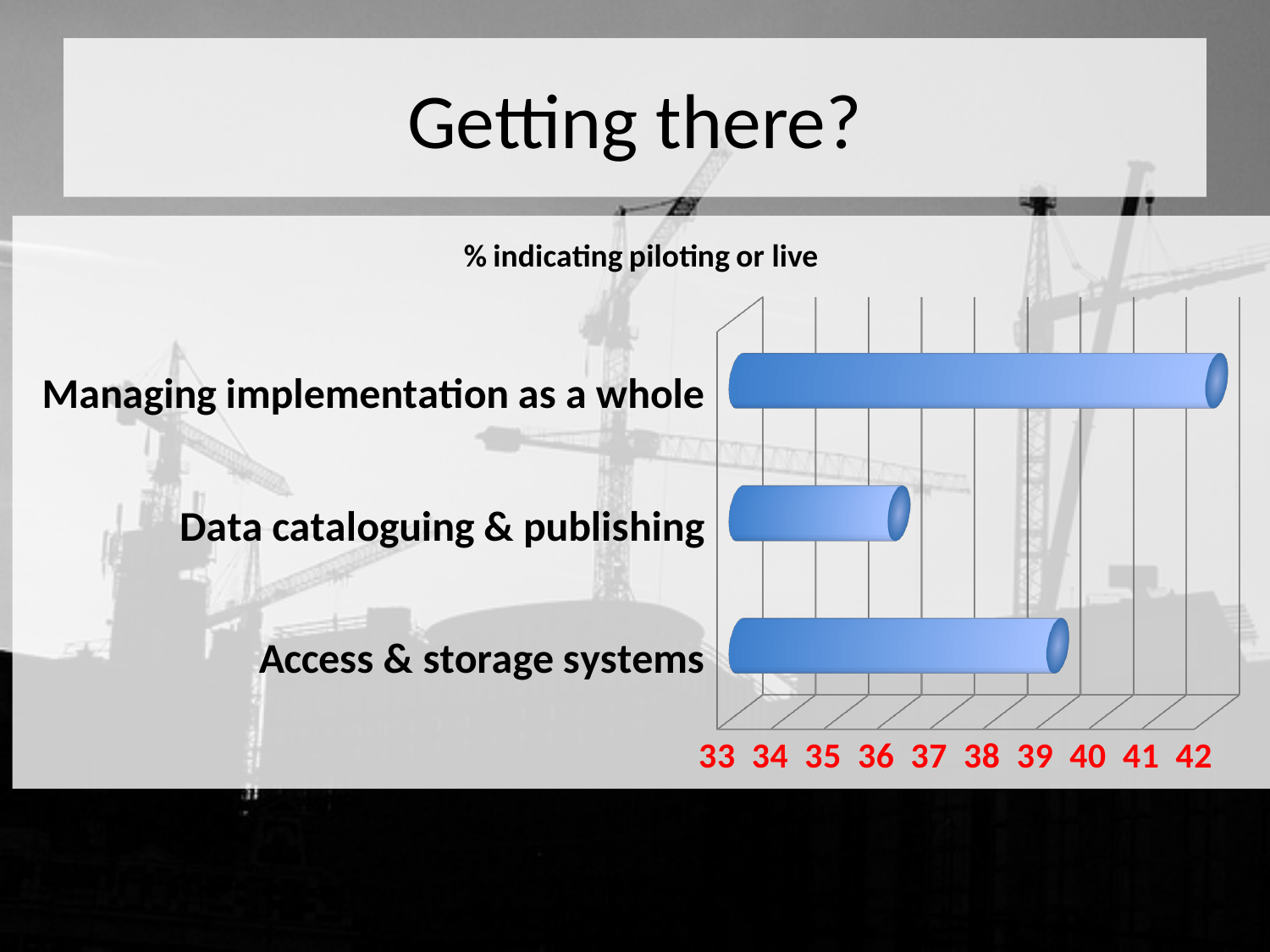
What kind of chart is shown on the slide? bar chart Which category has the lowest value? Data cataloguing & publishing Which category has the highest value? Managing implementation as a whole Is the value for Data cataloguing & publishing greater or less than 38? less Which is larger, the value for Managing implementation as a whole or the value for Access & storage systems? Managing implementation as a whole How many categories are plotted in the chart? 3 Is the value for Access & storage systems greater or less than 37? greater What is the lowest value shown on the horizontal axis? 33 Is the value for Managing implementation as a whole greater or less than 40? greater What is the title of the chart? % indicating piloting or live Which is larger, the value for Access & storage systems or the value for Data cataloguing & publishing? Access & storage systems